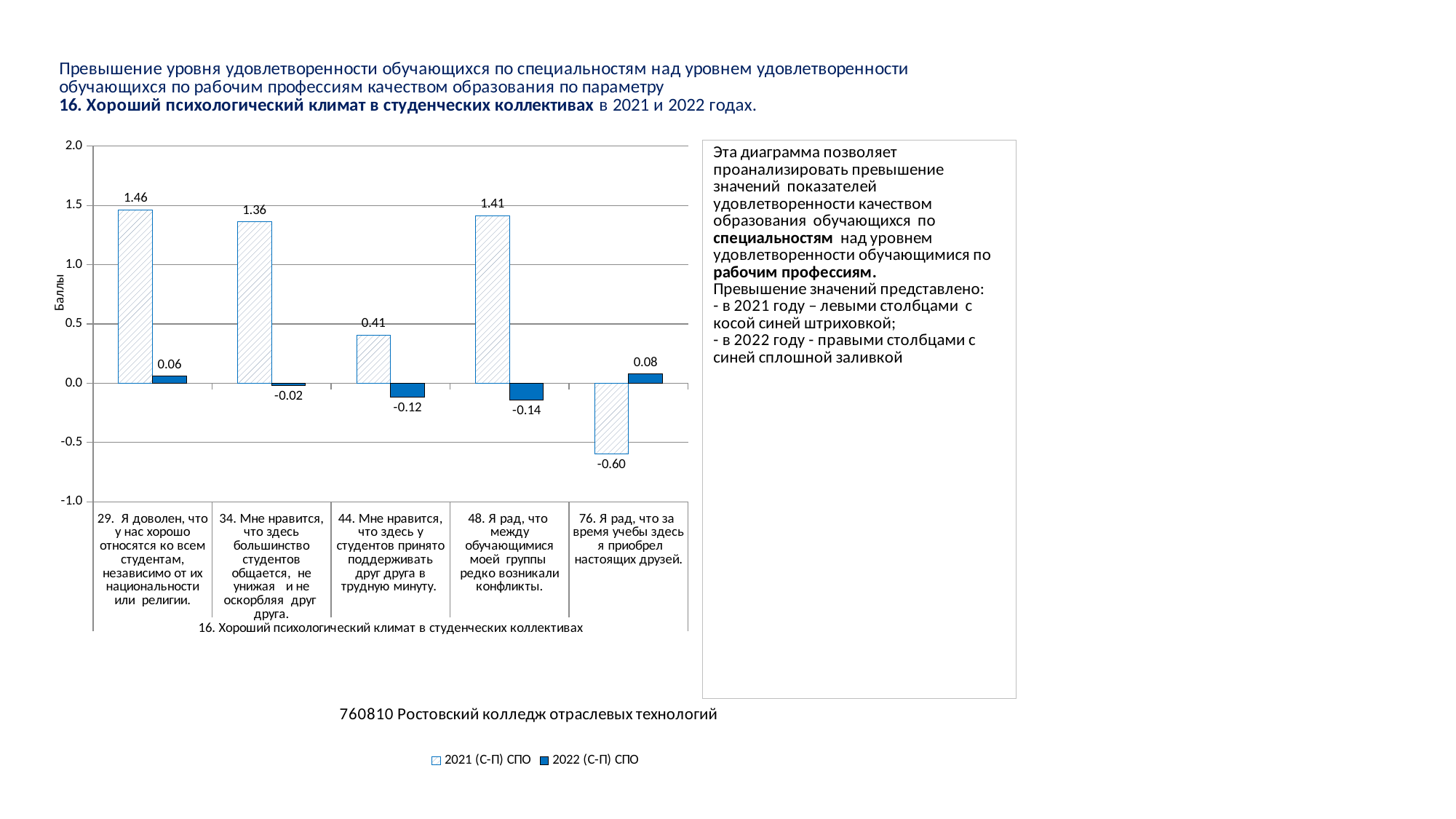
What is the 2021 (С-П) СПО value for category 29 (Я доволен, что у нас хорошо относятся ко всем студентам...)? 1.46 How many series does the legend list? 2 Which category has the lowest 2022 (С-П) СПО value? 48. Я рад, что между обучающимися моей группы редко возникали конфликты. What is the 2021 (С-П) СПО value for category 76 (Я рад, что за время учебы здесь я приобрел настоящих друзей)? -0.60 What is the label of the vertical axis? Баллы Which is larger: the 2022 (С-П) СПО value for category 29 or for category 76? Category 76 (0.08) Which category has the highest 2021 (С-П) СПО value? 29. Я доволен, что у нас хорошо относятся ко всем студентам, независимо от их национальности или религии. Which series is shown with solid blue fill according to the legend? 2022 (С-П) СПО What is the difference between the 2021 (С-П) СПО values for category 29 and category 44? 1.05 What kind of chart is shown on the slide? Bar chart How many categories are shown on the x axis? 5 What is the 2022 (С-П) СПО value for category 48 (Я рад, что между обучающимися моей группы редко возникали конфликты)? -0.14